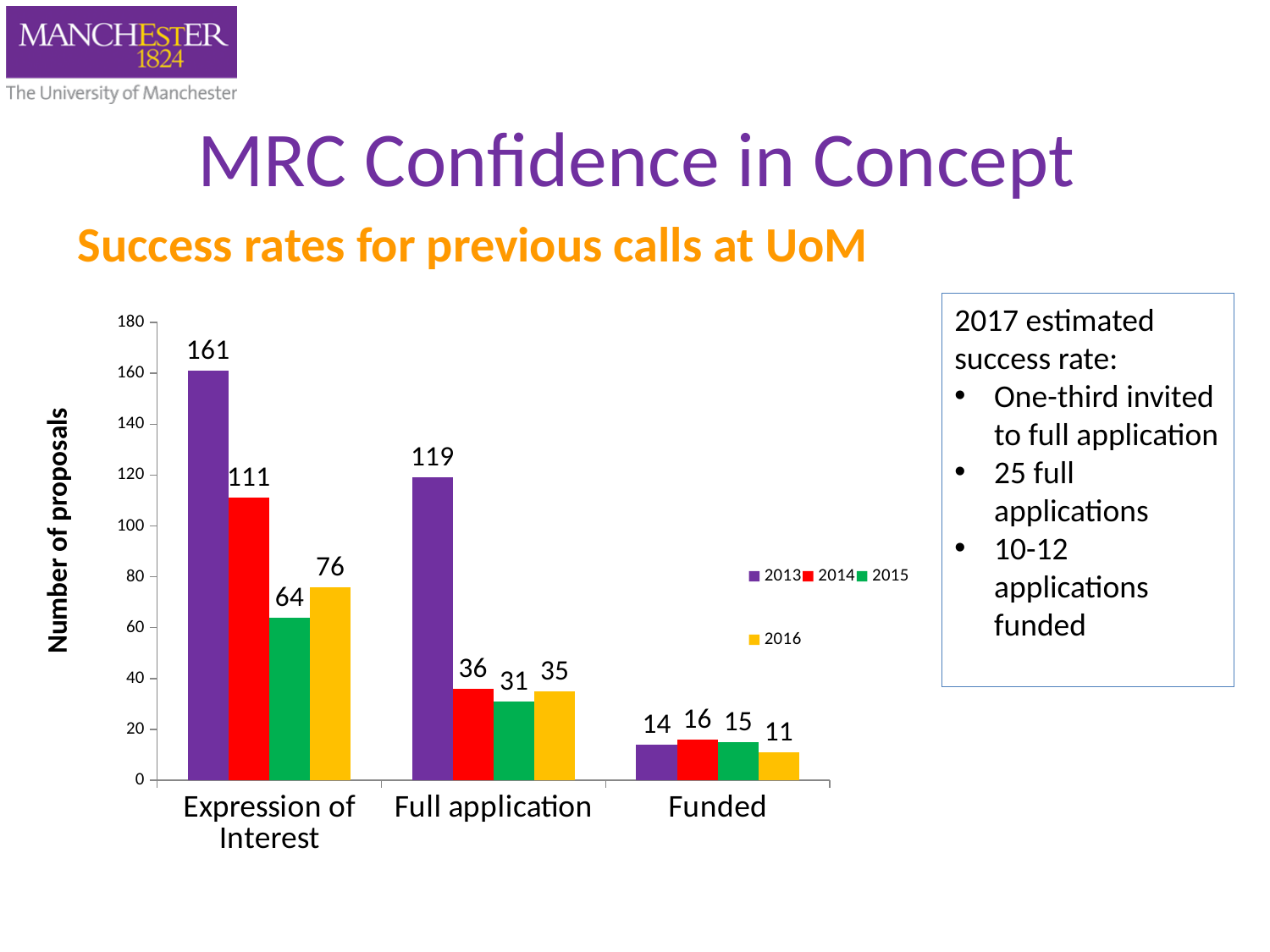
Which year has the lowest value in the Funded category? 2016 How many series does the legend list? 4 Is the value for 2016 in the Expression of Interest category greater or less than 60? greater How many categories are shown on the x axis? 3 What is the difference between the 2013 and 2014 values in the Expression of Interest category? 50 What is the value for 2016 in the Full application category? 35 What is the value for 2014 in the Funded category? 16 Which year has the highest value in the Expression of Interest category? 2013 What is the value for 2013 in the Expression of Interest category? 161 What kind of chart is shown on the slide? bar chart What is the label of the y axis? Number of proposals Which is larger in the Full application category: the 2014 value or the 2015 value? 2014